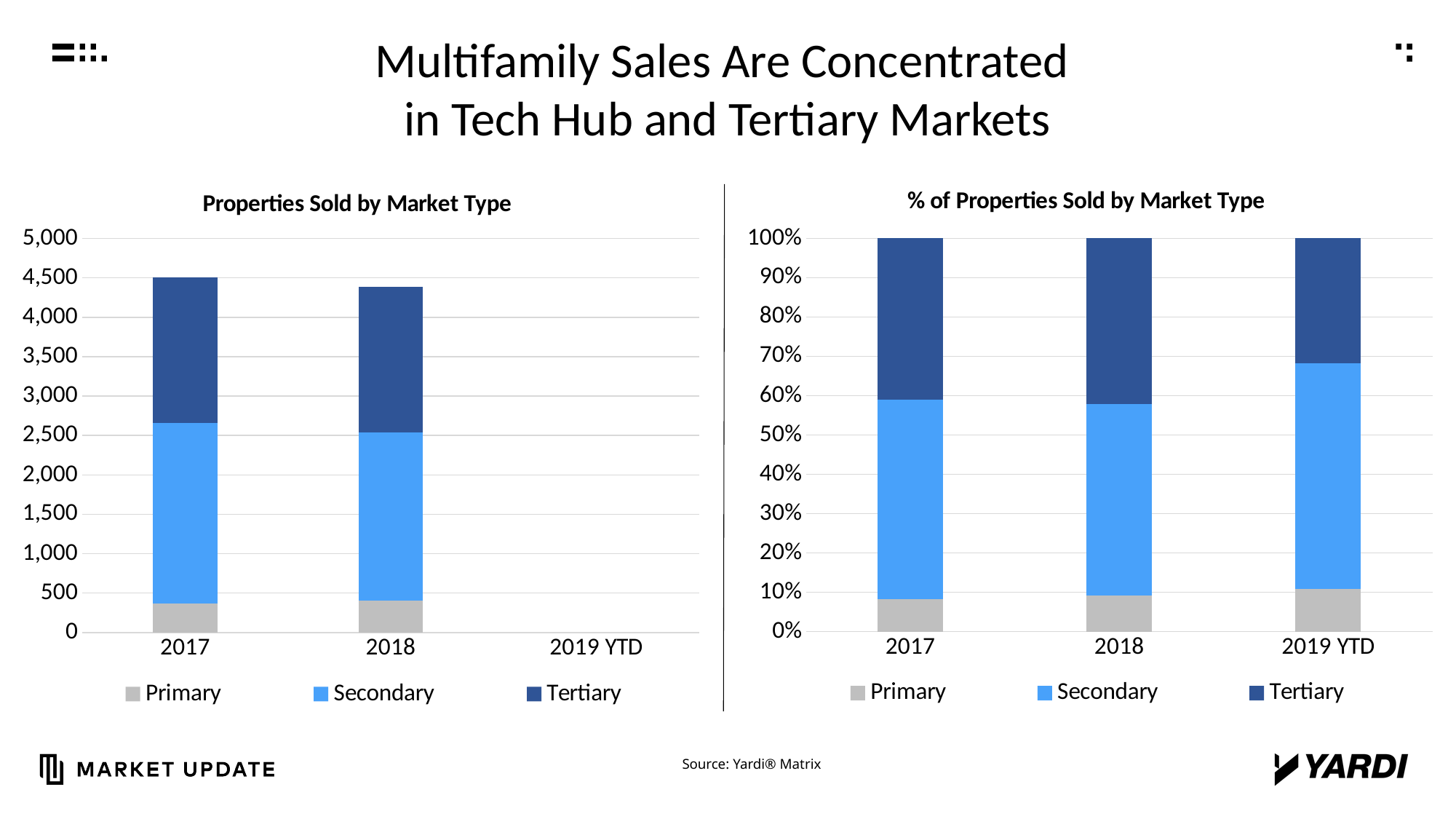
How many series does the legend of the 'Properties Sold by Market Type' chart list? 3 In the '% of Properties Sold by Market Type' chart, is the Primary share for 2017 greater or less than 10%? less In the 'Properties Sold by Market Type' chart, is the Primary segment for 2017 greater or less than 500? less In the '% of Properties Sold by Market Type' chart, is the Tertiary share for 2019 YTD greater or less than 40%? less In the '% of Properties Sold by Market Type' chart, how many bars are plotted? 3 What kind of chart is the 'Properties Sold by Market Type' chart on the left? Stacked bar chart What is the title of the chart on the right side of the slide? % of Properties Sold by Market Type Which series is shown in grey in the legend of the 'Properties Sold by Market Type' chart? Primary In the '% of Properties Sold by Market Type' chart, which year has the larger Tertiary share, 2017 or 2019 YTD? 2017 In the '% of Properties Sold by Market Type' chart, does the Tertiary share rise or fall from 2017 to 2019 YTD? fall In the 'Properties Sold by Market Type' chart, which year has the taller total bar, 2017 or 2018? 2017